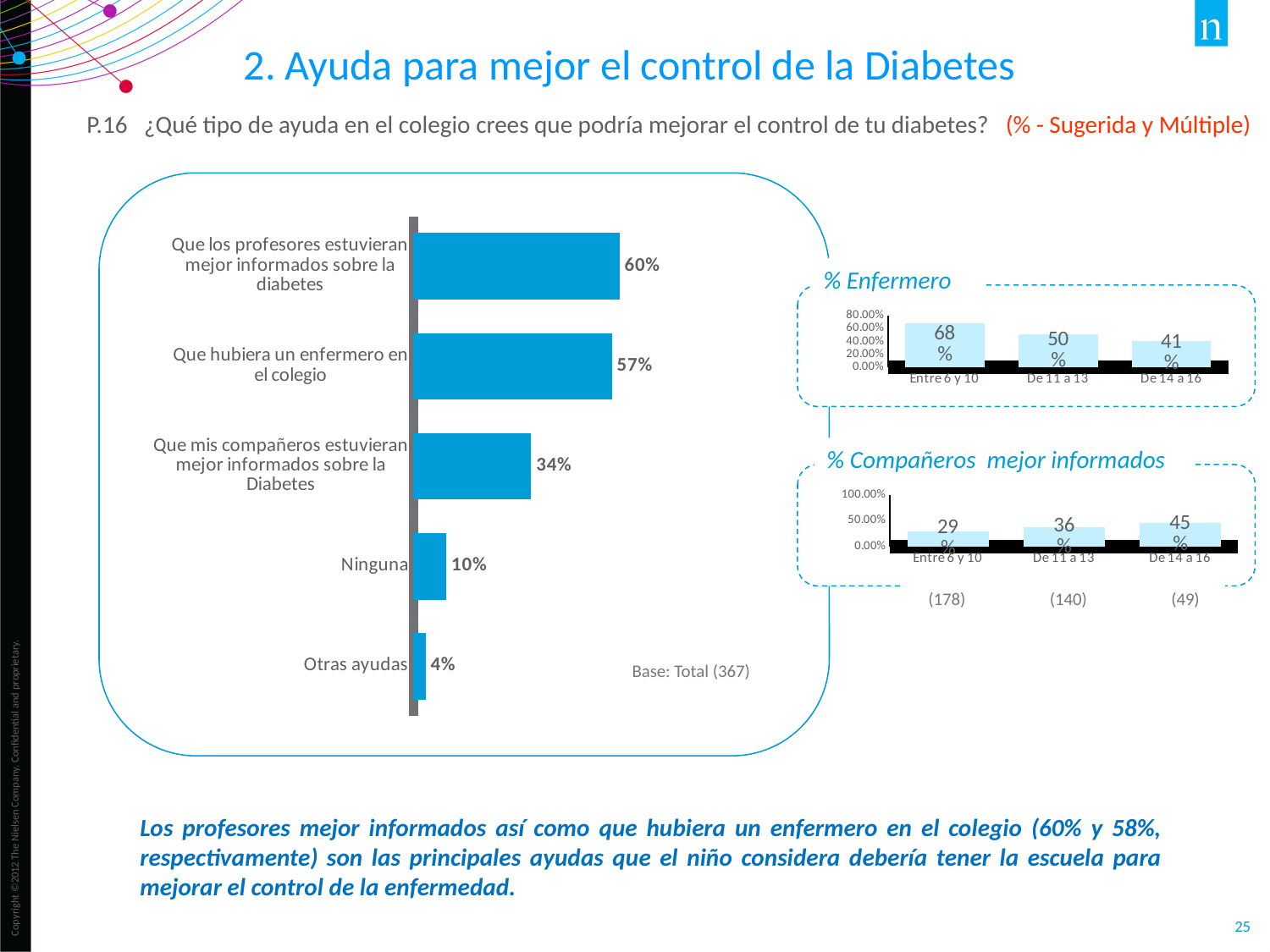
In the '% Enfermero' chart, which is larger: the value for 'De 11 a 13' or 'De 14 a 16'? De 11 a 13 In the '% Compañeros mejor informados' chart, what is the difference between 'De 14 a 16' and 'Entre 6 y 10'? 16% In the main horizontal bar chart, how many categories are shown? 5 In the main horizontal bar chart, what is the value for 'Ninguna'? 10% In the '% Compañeros mejor informados' chart, which age group has the highest value? De 14 a 16 In the main horizontal bar chart, which category has the highest value? Que los profesores estuvieran mejor informados sobre la diabetes In the main horizontal bar chart, which category has the lowest value? Otras ayudas In the '% Enfermero' chart, do the values rise or fall from 'Entre 6 y 10' to 'De 14 a 16'? fall In the main horizontal bar chart, what is the value for 'Que hubiera un enfermero en el colegio'? 57% What kind of chart is the main chart on the left of the slide? bar chart In the main horizontal bar chart, what is the difference between 'Que los profesores estuvieran mejor informados sobre la diabetes' and 'Que mis compañeros estuvieran mejor informados sobre la Diabetes'? 26% In the '% Enfermero' chart, what is the value for 'Entre 6 y 10'? 68%